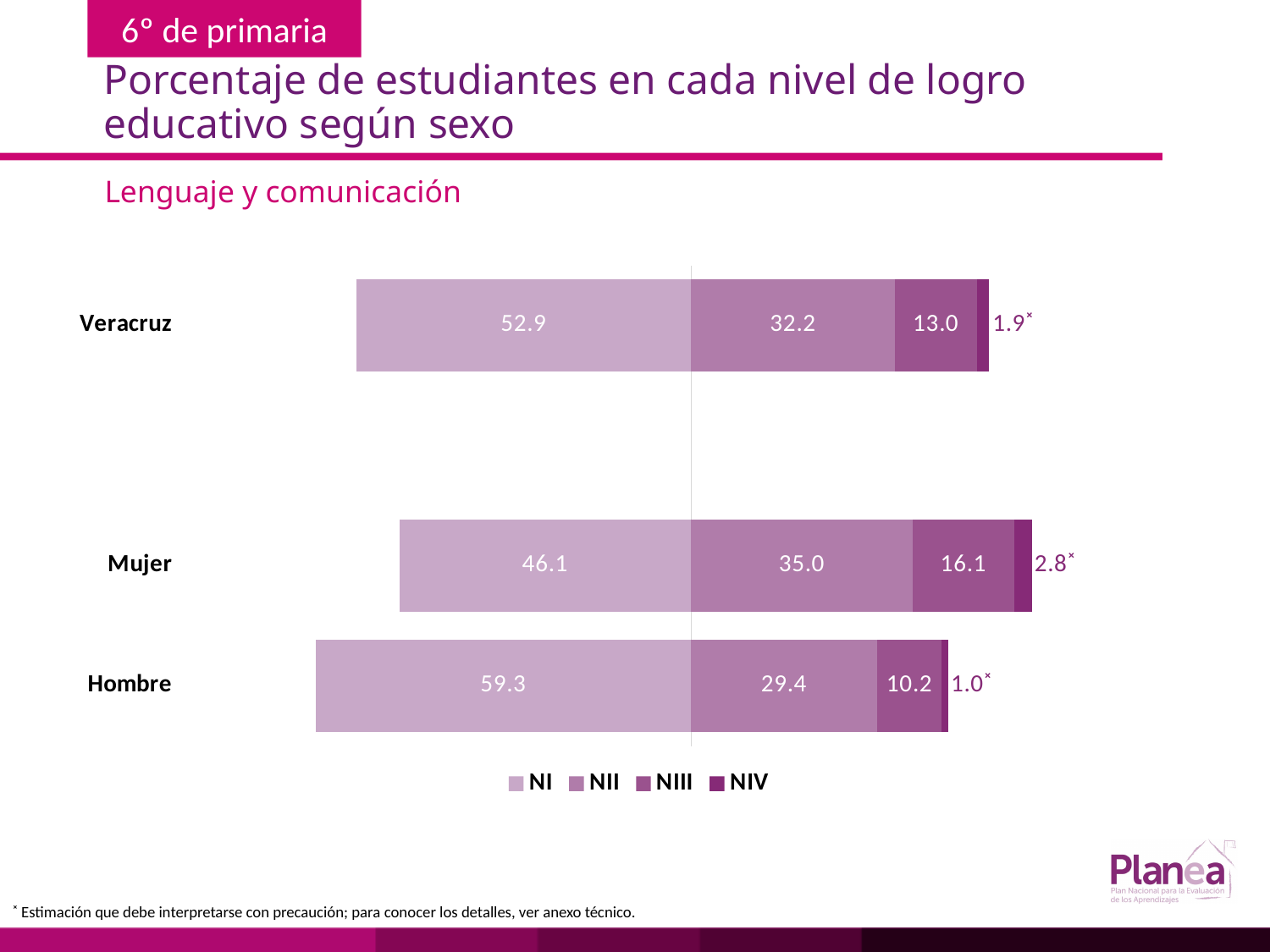
Which category has the highest NI value? Hombre What is the difference between the NI values for Hombre and Mujer? 13.2 How many series does the legend list? 4 What is the subtitle shown above the chart? Lenguaje y comunicación What kind of chart is shown on the slide? Stacked bar chart What is the NII value for Mujer? 35.0 How many categories are shown on the chart? 3 Which is larger, the NIII value for Mujer or the NIII value for Veracruz? Mujer What is the NIII value for Hombre? 10.2 What is the NI value for Veracruz? 52.9 What is the NIV value for Mujer? 2.8 Which category has the lowest NIV value? Hombre